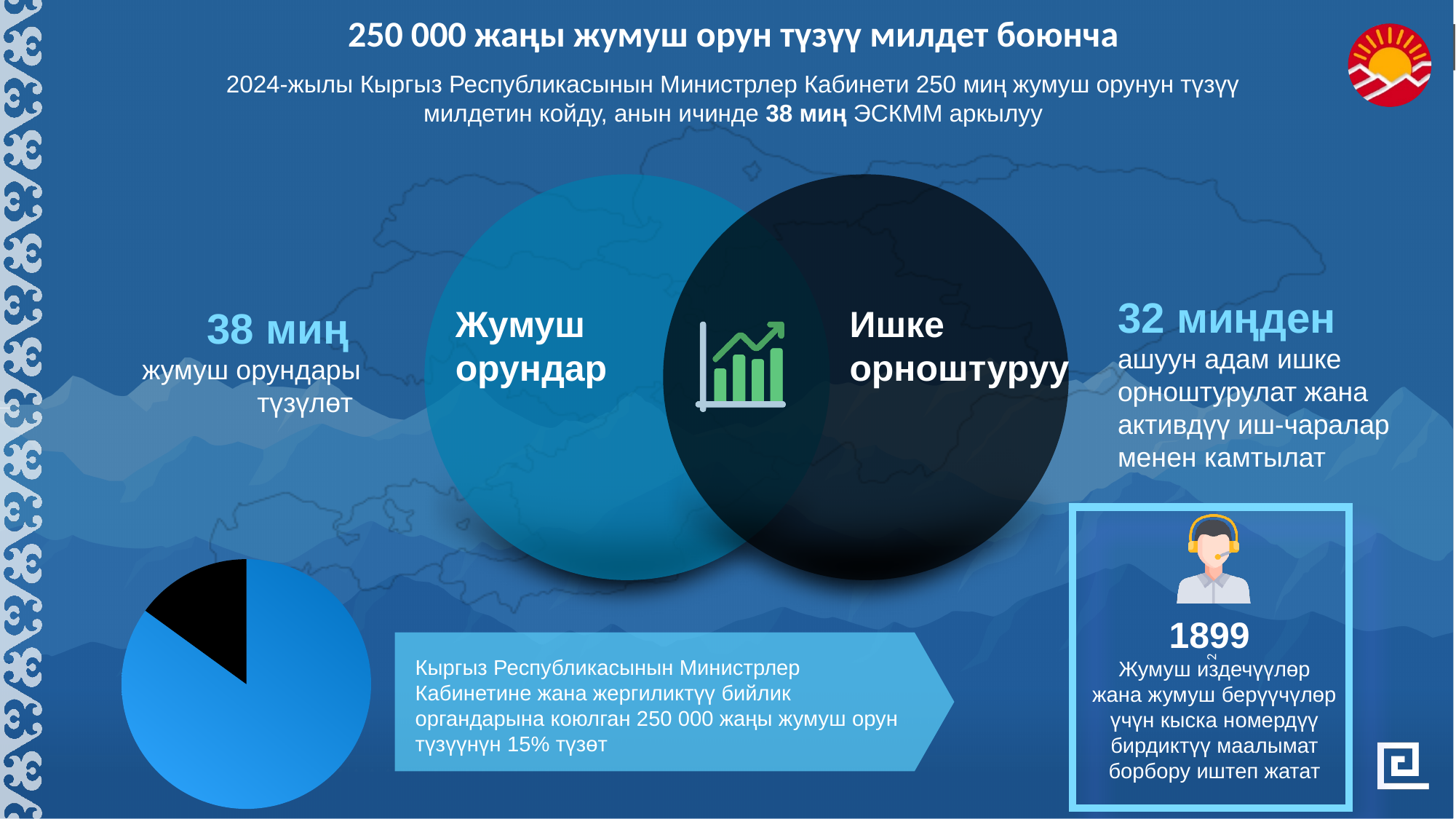
Is the black slice of the pie chart at the bottom left greater or less than half of the pie? less How many slices does the pie chart at the bottom left have? 2 Does the pie chart at the bottom left have a legend? No Which colour slice is the smallest in the pie chart at the bottom left? black Which colour slice is the largest in the pie chart at the bottom left? blue According to the text box next to the pie chart, what share of the 250 000 new jobs does the smaller slice represent? 15% What kind of chart is shown at the bottom left of the slide? pie chart In the pie chart at the bottom left, which slice is larger, the blue one or the black one? the blue one